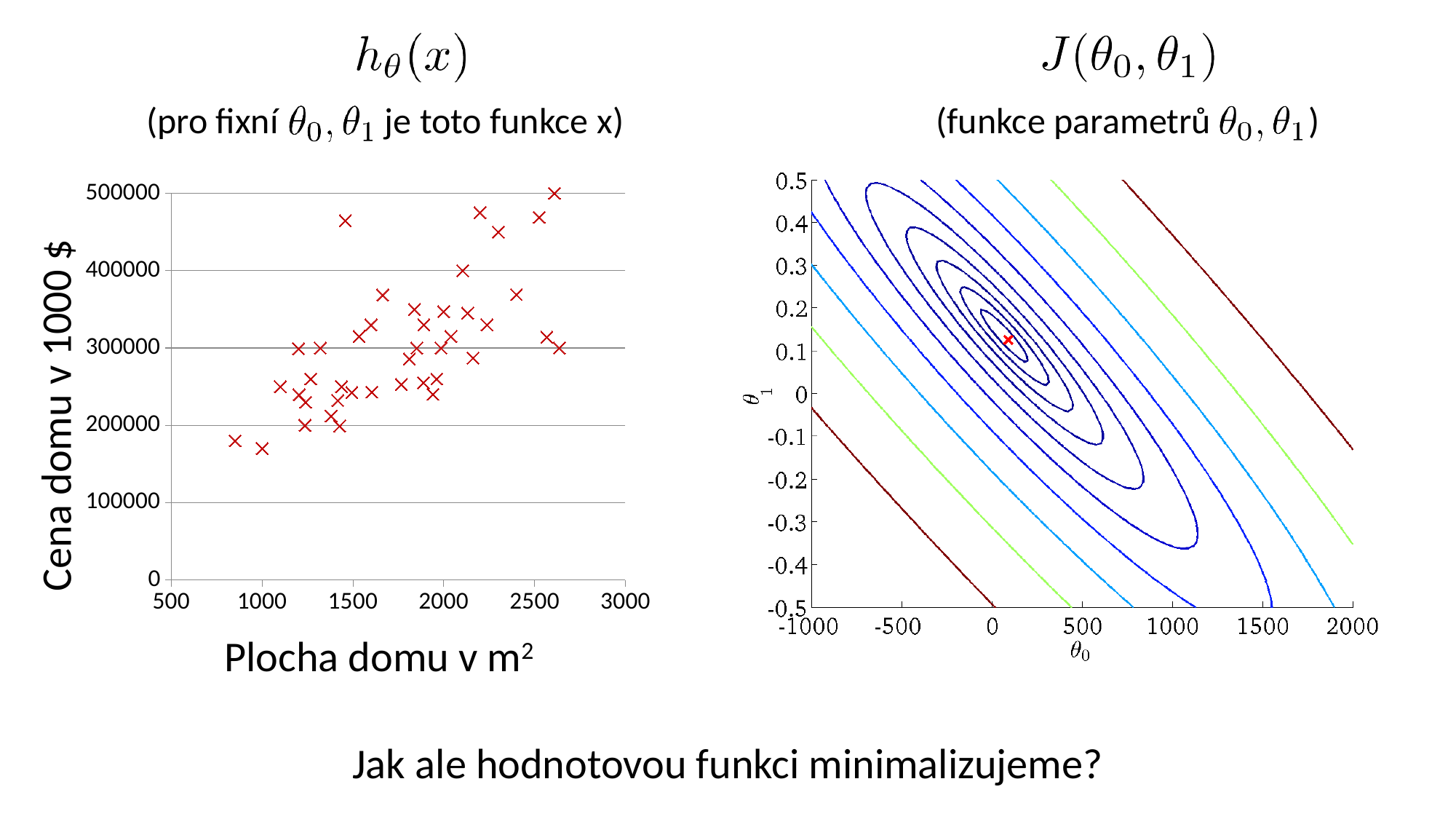
What is the lowest tick value shown on the x axis of the left chart? 500 In the left chart, is the highest plotted house price greater or less than 400000? greater In the left chart, is the price of the house with the largest area (around 2650 m²) greater or less than 400000? less What kind of chart is the left chart (h_θ(x))? scatter plot What is the highest tick value shown on the y axis of the left chart? 500000 In the left chart, do house prices generally rise or fall as the house area increases? rise What kind of chart is the right chart (J(θ0, θ1))? contour plot What is the range of the x axis (θ0) in the right chart? -1000 to 2000 In the right chart, is the θ0 coordinate of the red x marker greater or less than 500? less What is the range of the y axis (θ1) in the right chart? -0.5 to 0.5 What is the label of the x axis of the left chart? Plocha domu v m²